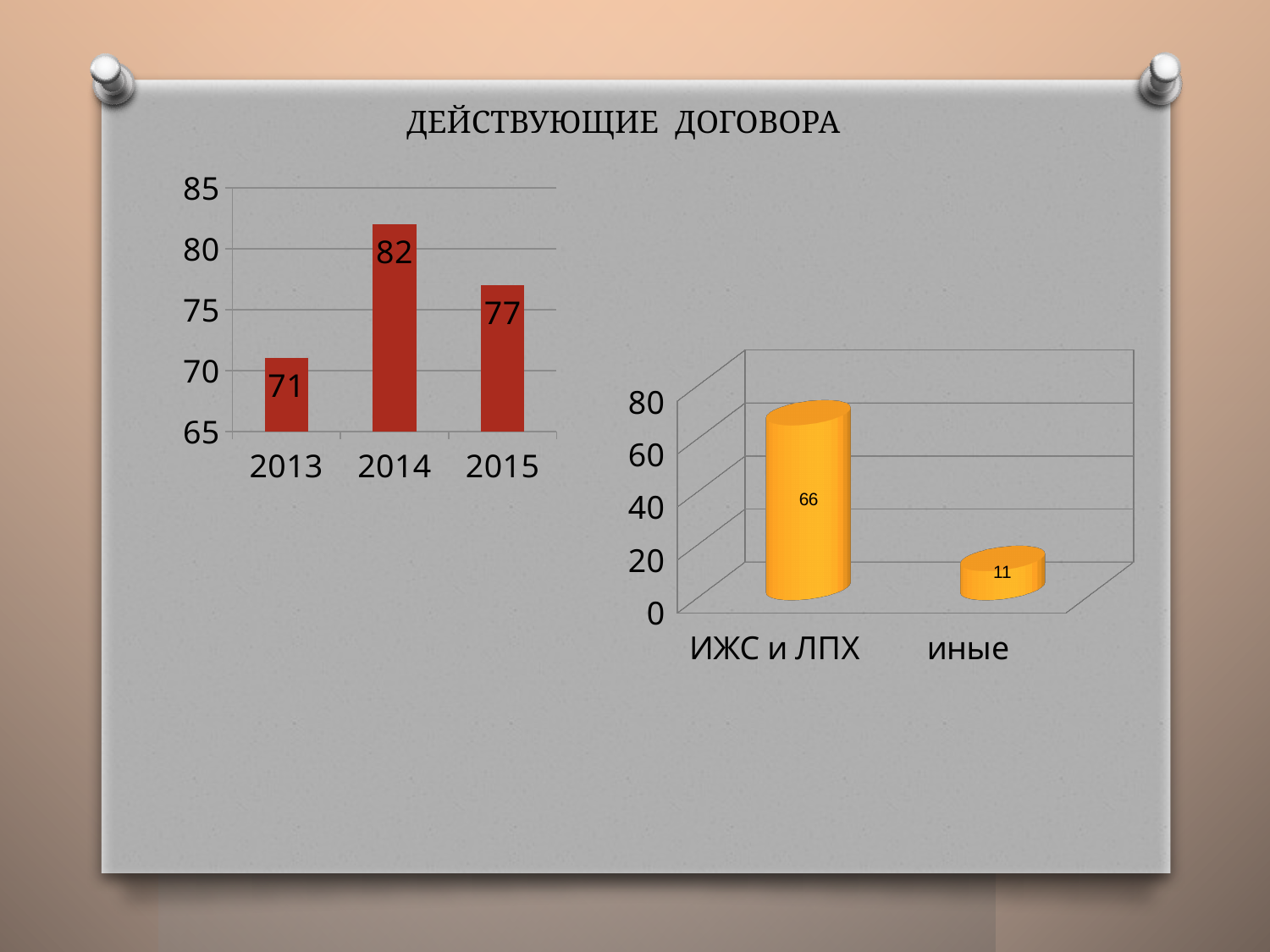
In the left chart, how many years are shown? 3 What is the title of the slide above the charts? ДЕЙСТВУЮЩИЕ ДОГОВОРА In the left chart, which year has the highest value? 2014 In the right chart, what is the value for ИЖС и ЛПХ? 66 In the right chart, what is the difference between the values for ИЖС и ЛПХ and иные? 55 In the right chart, is the value for ИЖС и ЛПХ greater or less than 60? greater In the left chart, which year has the lowest value? 2013 In the left chart, what is the difference between the values for 2014 and 2015? 5 In the right chart, what is the value for иные? 11 In the left chart, what is the value for 2014? 82 In the left chart, which is larger, the value for 2015 or the value for 2013? 2015 In the left chart, what is the value for 2013? 71